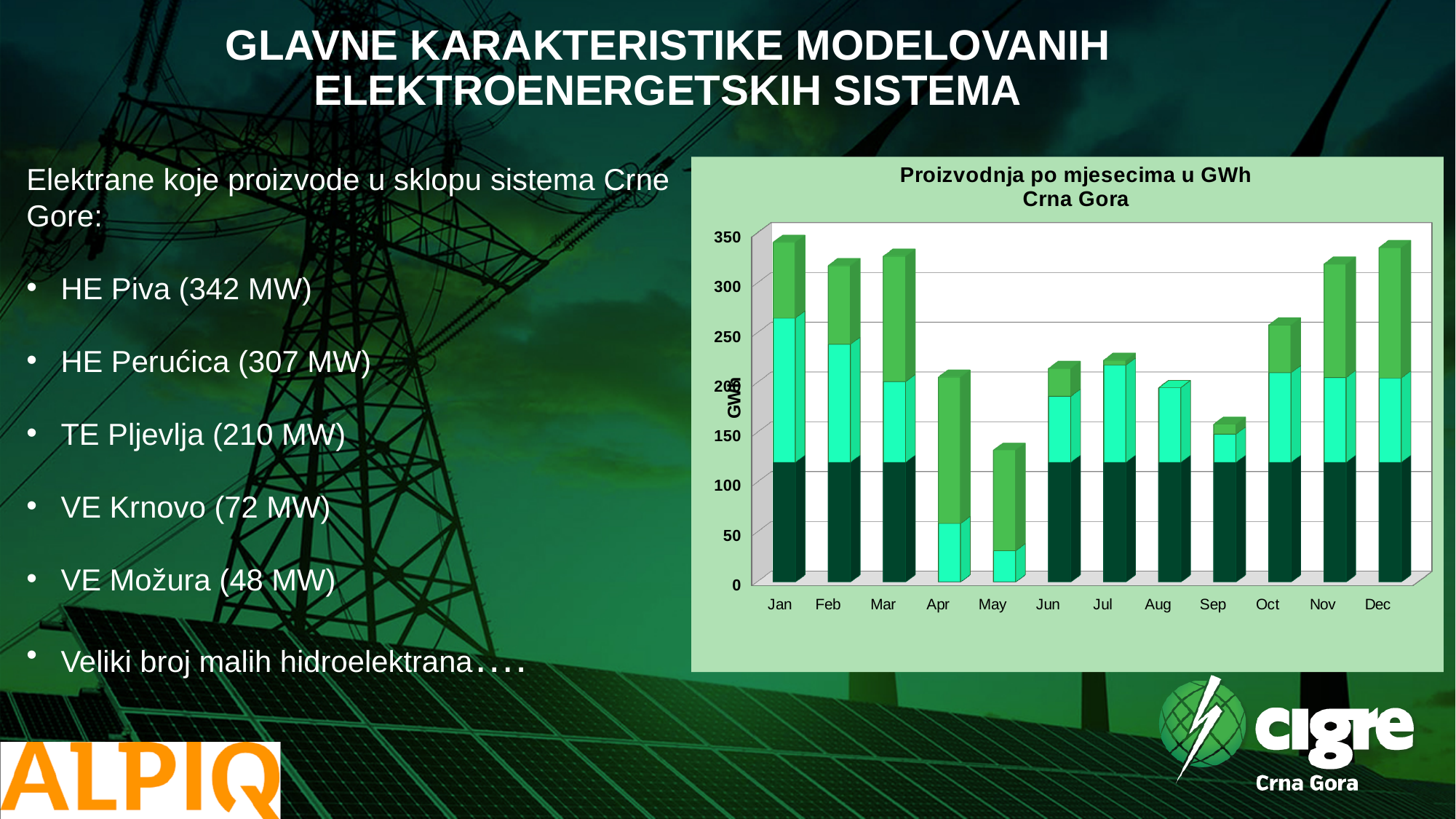
Is the total value for Apr greater or less than 150? greater What kind of chart is shown on the slide? Stacked bar chart Is the total value for Oct greater or less than 300? less Which month has the larger total production, Nov or Apr? Nov Which month has the larger total production, Jan or May? Jan Is the total value for May greater or less than 150? less Which month has the lowest total production in the chart? May What is the title of the chart? Proizvodnja po mjesecima u GWh Crna Gora How many months (categories) are shown on the x axis of the chart? 12